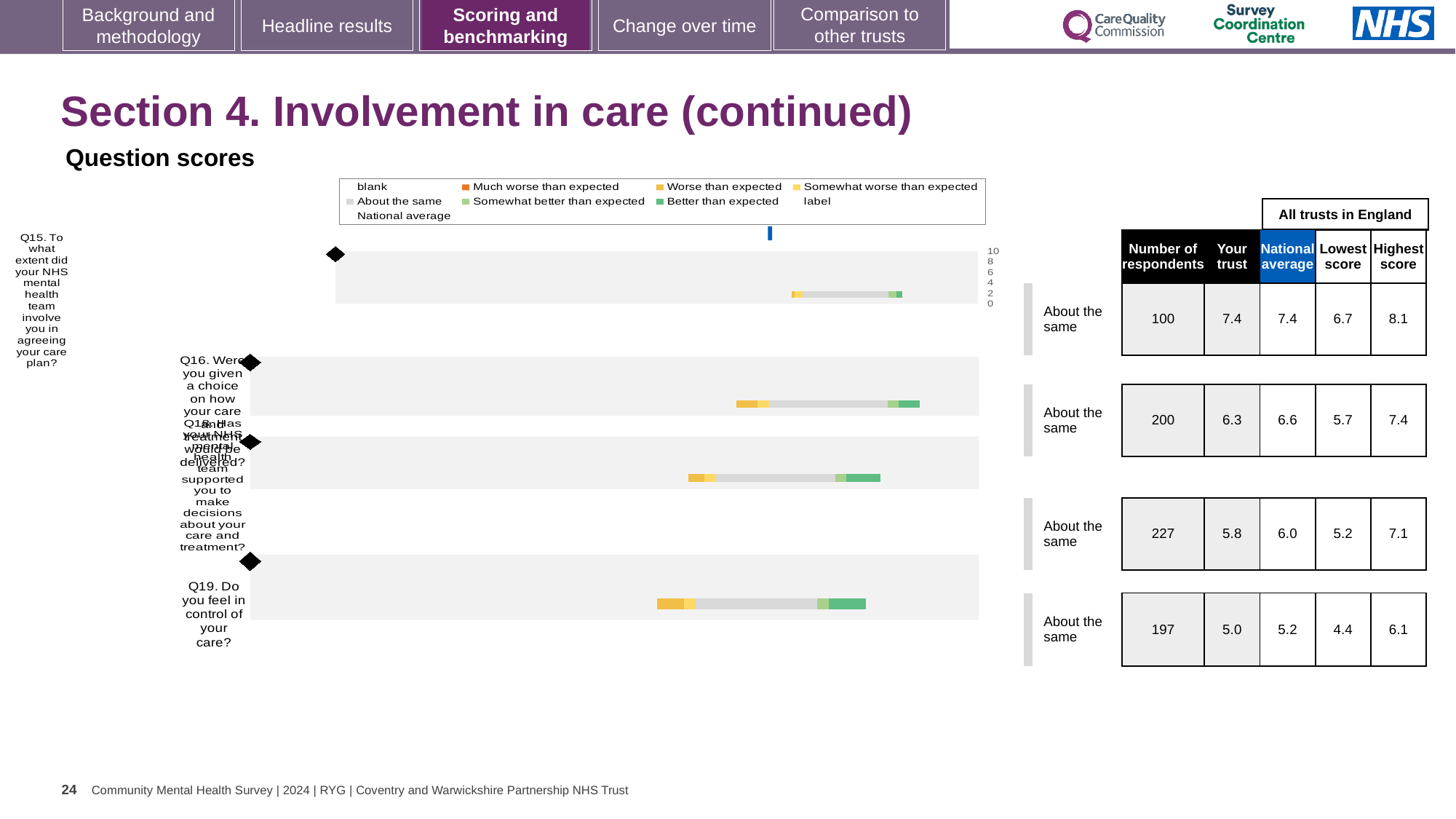
What kind of chart is used to show the question scores on this slide? bar chart What is the difference between the national average and the 'Your trust' score for Q16? 0.3 What is the national average score for Q19 (feeling in control of your care)? 5.2 What is the highest score across all trusts in England for Q16 (choice on how care would be delivered)? 7.4 Which question has the highest 'Your trust' score? Q15 How many respondents answered Q18 (team supported you to make decisions)? 227 Which question has the lowest 'Your trust' score? Q19 What benchmark category is shown for Q15 in the question scores chart? About the same What is the 'Your trust' score for Q15 (involvement in agreeing your care plan)? 7.4 What is the difference between the highest and lowest scores in England for Q19? 1.7 How many questions (categories) are plotted in the question scores chart? 4 Is the 'Your trust' score for Q18 larger or smaller than the national average for Q18? smaller